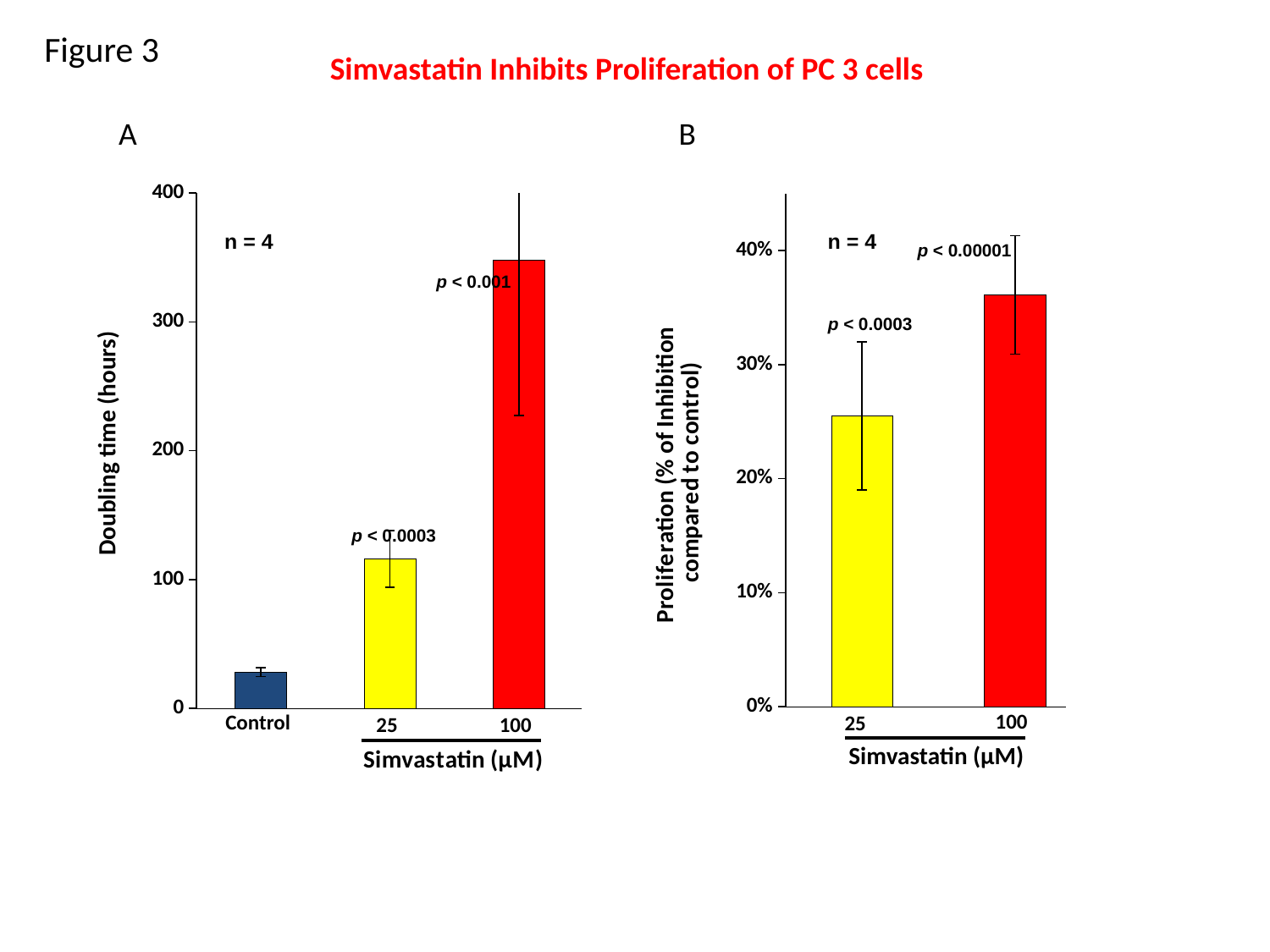
In chart B (Proliferation), is the value for 100 µM simvastatin greater or less than 30%? greater In chart A (Doubling time), which category has the lowest doubling time? Control In chart A (Doubling time), do the values rise or fall from Control to 100 µM along the x axis? rise In chart A (Doubling time), is the value for 100 µM simvastatin greater or less than 300? greater How many bars are plotted in chart B (Proliferation)? 2 What is the title of the slide's figure shown above the two charts? Simvastatin Inhibits Proliferation of PC 3 cells What kind of chart is chart A (Doubling time)? bar chart In chart B (Proliferation), is the value for 25 µM simvastatin greater or less than 30%? less How many bars are plotted in chart A (Doubling time)? 3 In chart B (Proliferation), which category has the higher percentage of inhibition? 100 In chart A (Doubling time), which category has the highest doubling time? 100